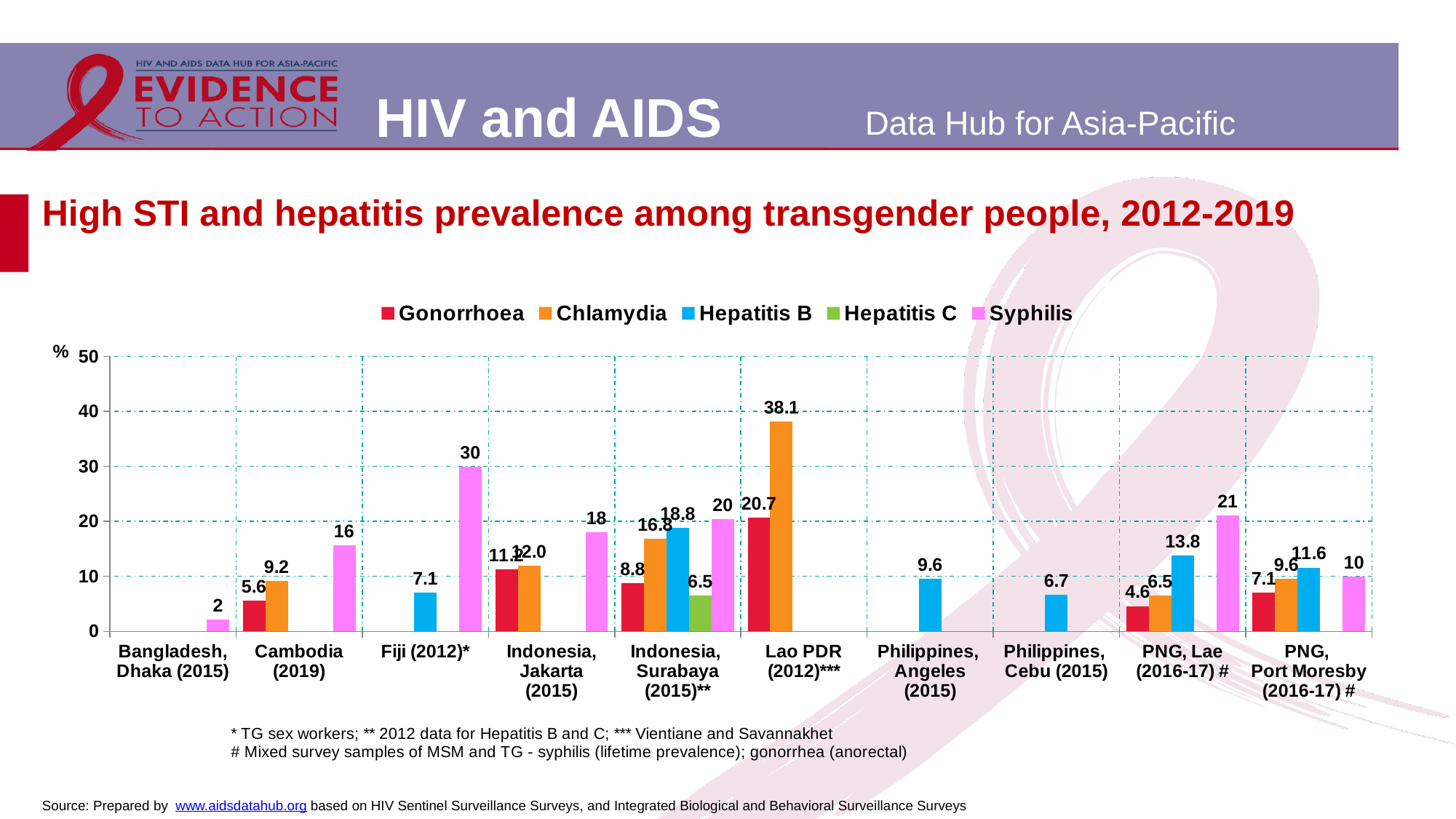
Which has the higher Hepatitis B value, Philippines, Angeles (2015) or Philippines, Cebu (2015)? Philippines, Angeles (2015) What is the Hepatitis B value for PNG, Lae (2016-17) #? 13.8 How many series does the legend list? 5 Which location has the highest Syphilis prevalence? Fiji (2012)* What is the difference between the Chlamydia and Gonorrhoea values for Lao PDR (2012)***? 17.4 Which location has the lowest Syphilis prevalence? Bangladesh, Dhaka (2015) How many locations are shown on the x axis? 10 What is the difference between the Syphilis values for PNG, Lae (2016-17) # and PNG, Port Moresby (2016-17) #? 11 What kind of chart is shown on the slide? Bar chart Which location has the highest Gonorrhoea prevalence? Lao PDR (2012)*** What is the Hepatitis C value for Indonesia, Surabaya (2015)**? 6.5 What is the Chlamydia prevalence for Lao PDR (2012)***? 38.1